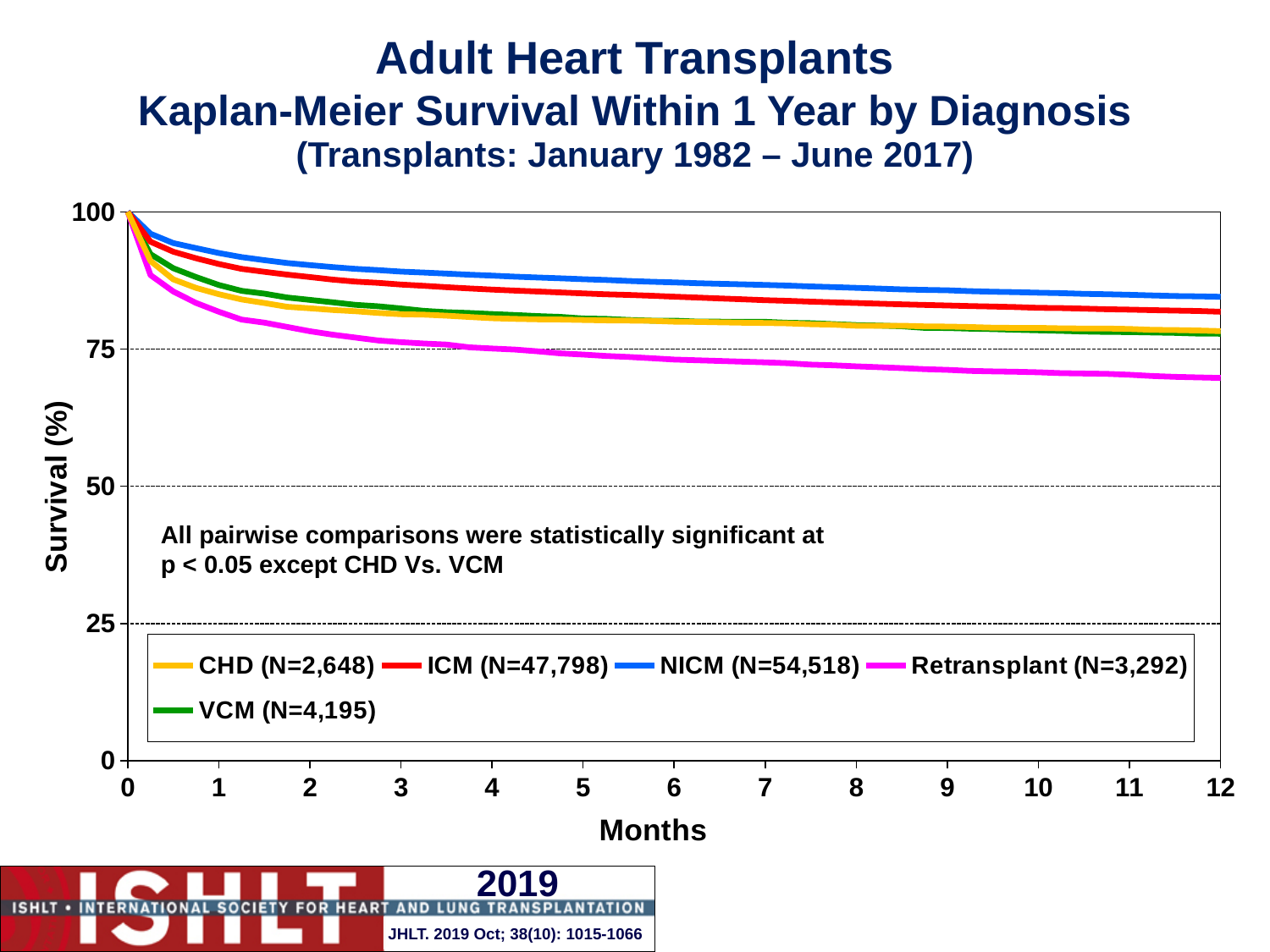
How many series does the legend list? 5 What is the N for the ICM group shown in the legend? 47,798 Is the survival for NICM at 12 months greater or less than 75? greater Which diagnosis group has the highest survival at 12 months? NICM What kind of chart is shown on the slide? Line chart What is the maximum value shown on the x axis (Months)? 12 Do the survival curves rise or fall as months increase? Fall Is the survival for Retransplant at 12 months greater or less than 75? less Which diagnosis group has the lowest survival at 12 months? Retransplant What is the label of the y axis? Survival (%) Which has higher survival at 12 months, ICM or Retransplant? ICM Is the survival for ICM at 6 months greater or less than 75? greater